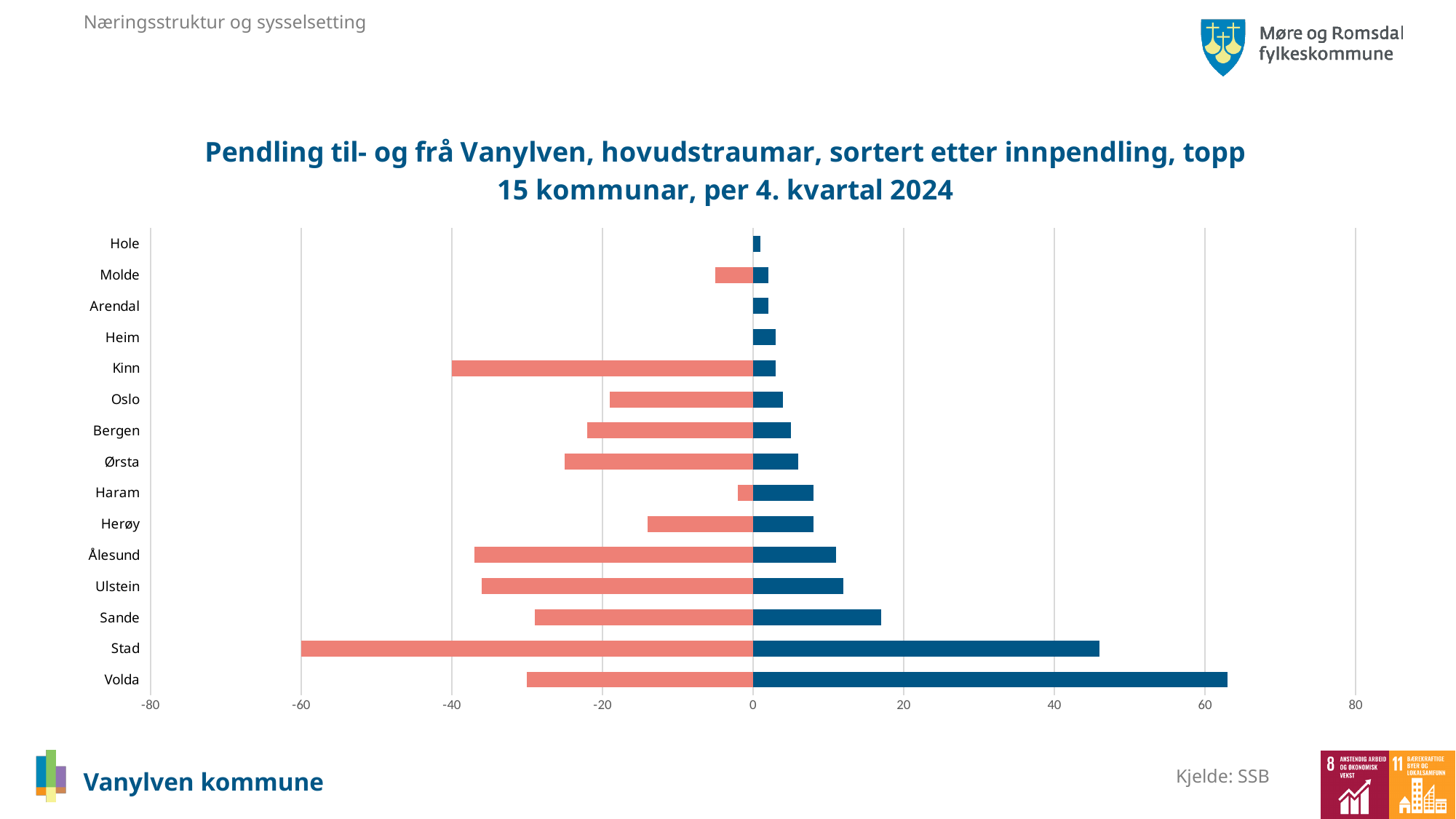
Is the red bar for Ålesund greater or less than -20? less What are the minimum and maximum values shown on the horizontal axis of the chart? -80 and 80 What kind of chart is shown on the slide? bar chart Which municipality has the longest blue (positive) bar in the chart? Volda Is the blue bar for Stad greater or less than 40? greater Which municipality has the longest red (negative) bar in the chart? Stad What is the source cited for the chart data on the slide? SSB Which has the larger blue bar, Volda or Stad? Volda Is the blue bar for Volda greater or less than 60? greater How many municipalities (categories) are listed on the vertical axis of the chart? 15